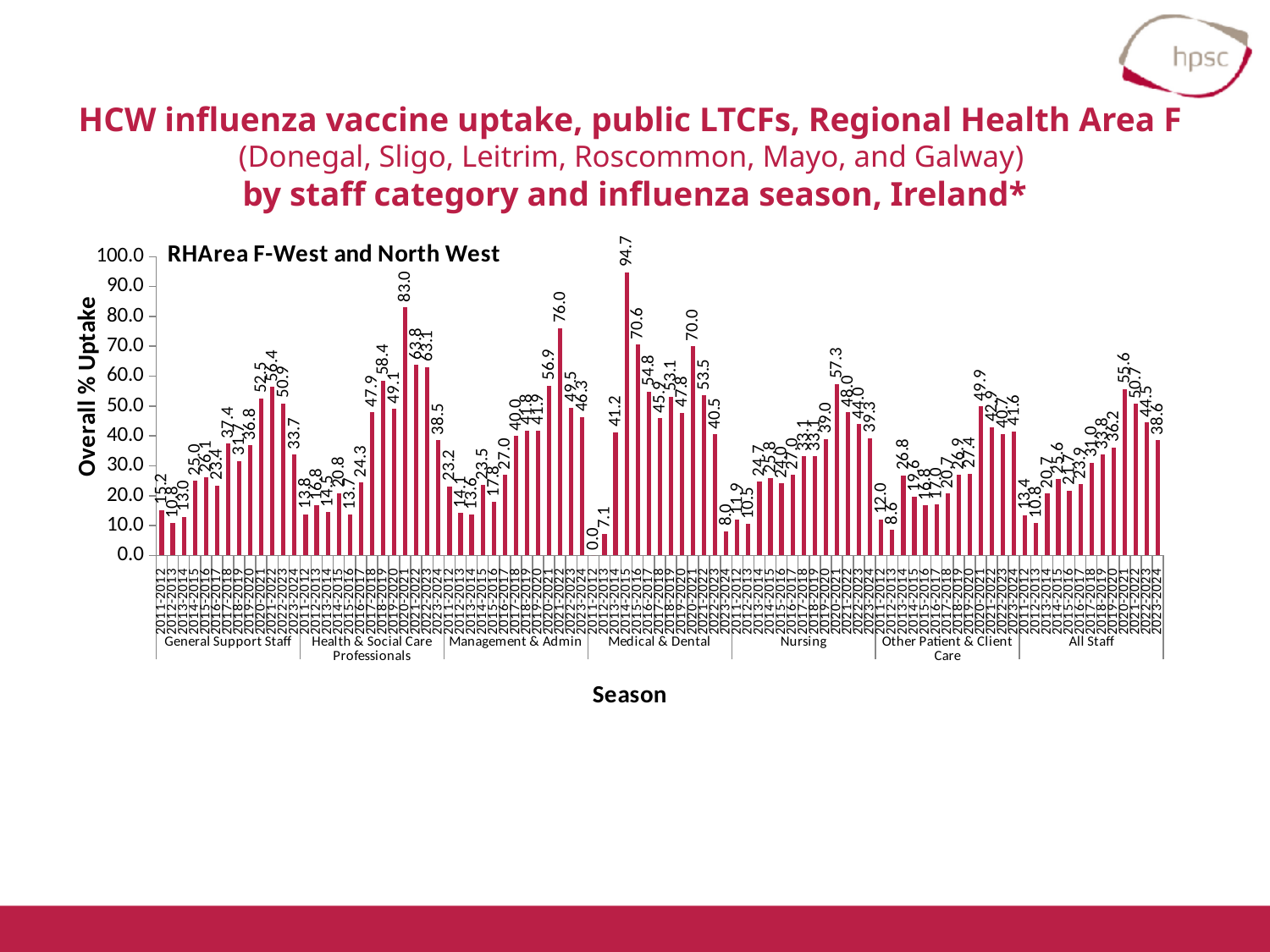
What is the difference between the All Staff uptake in 2020-2021 (55.6) and in 2023-2024 (38.6)? 17.0 Which staff category and season has the highest overall % uptake on the chart? Medical & Dental, 2014-2015 (94.7) What kind of chart is shown on the slide? Bar chart What is the highest overall % uptake shown for Nursing? 57.3 Which is larger in the 2021-2022 season: the uptake for General Support Staff or for All Staff? General Support Staff In which season did All Staff have its highest overall % uptake? 2020-2021 What is the lowest value shown on the chart, and for which staff category? 0.0, Medical & Dental What is the label on the y axis of the chart? Overall % Uptake What is the overall % uptake for All Staff in the 2023-2024 season? 38.6 How many staff categories are shown along the x axis? 7